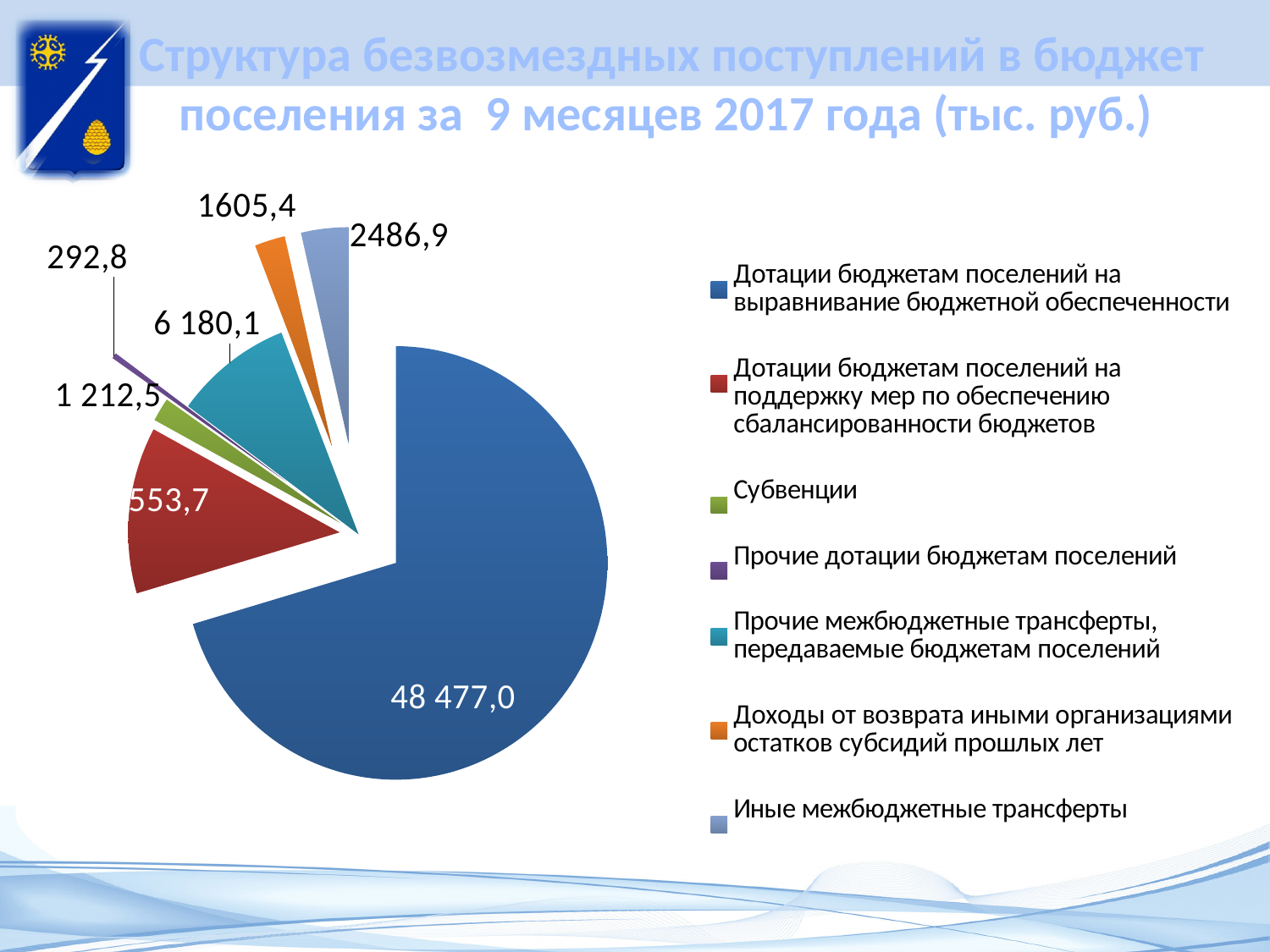
What is the value for «Прочие межбюджетные трансферты, передаваемые бюджетам поселений»? 6 180,1 Which category has the largest slice of the pie? Дотации бюджетам поселений на выравнивание бюджетной обеспеченности What is the value for «Дотации бюджетам поселений на выравнивание бюджетной обеспеченности»? 48 477,0 Which category has the smallest slice of the pie? Прочие дотации бюджетам поселений Which is larger: «Субвенции» or «Иные межбюджетные трансферты»? Иные межбюджетные трансферты What is the value for «Доходы от возврата иными организациями остатков субсидий прошлых лет»? 1605,4 What is the value for «Субвенции»? 1 212,5 What kind of chart is shown on the slide? pie chart What is the difference between «Иные межбюджетные трансферты» and «Доходы от возврата иными организациями остатков субсидий прошлых лет»? 881,5 What is the value for «Прочие дотации бюджетам поселений»? 292,8 What is the value for «Иные межбюджетные трансферты»? 2486,9 How many categories does the pie chart show? 7